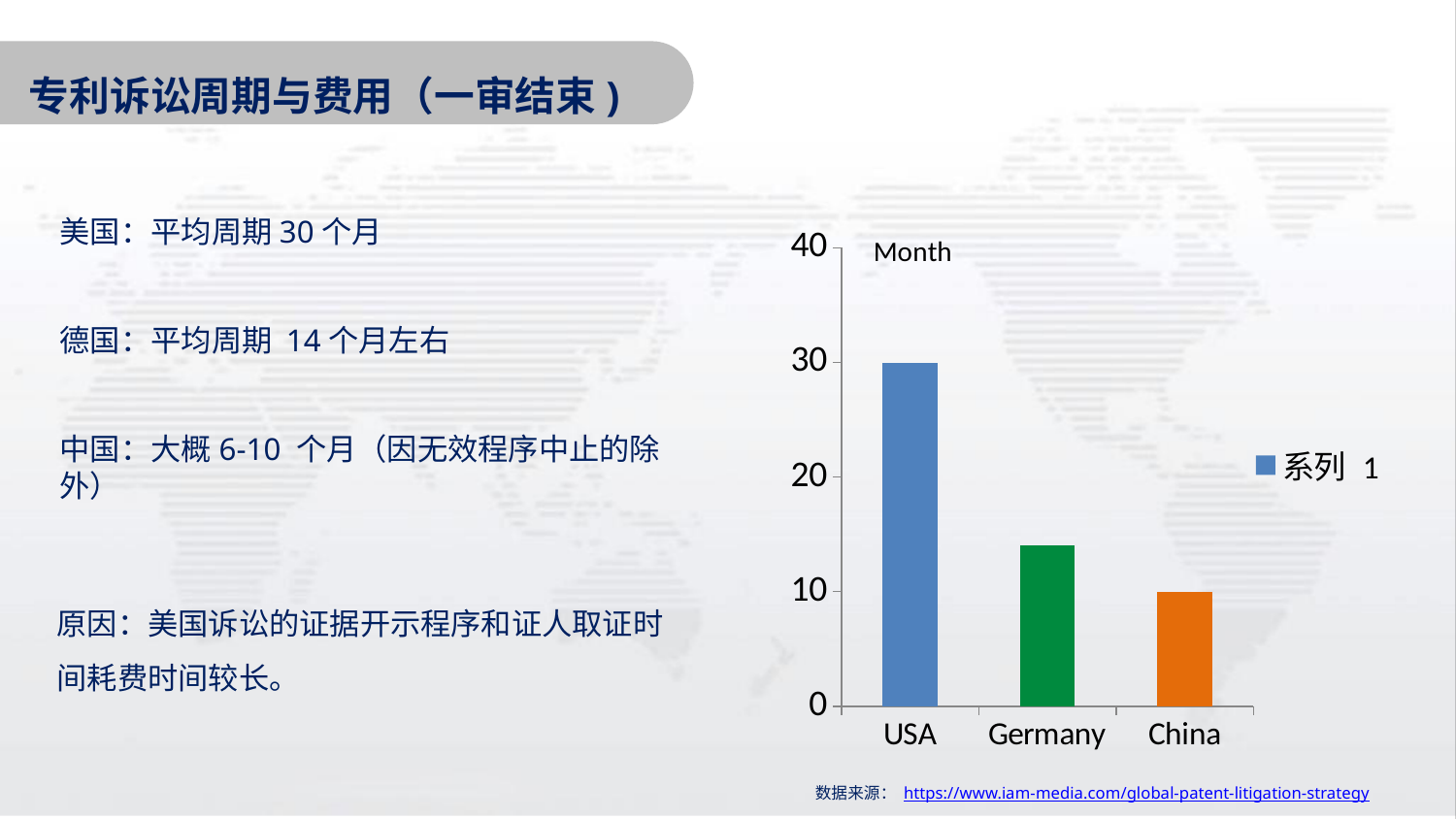
Which country has the lowest bar in the chart? China Which is larger, the value for Germany or the value for China? Germany Is the value for Germany greater or less than 10? greater What is the difference between the values for USA and China? 20 Is the value for Germany greater or less than 20? less How many countries are shown on the x axis of the chart? 3 Which country has the highest bar in the chart? USA What type of chart is shown on the slide? bar chart What is the value for China in the chart? 10 What is the value for USA in the chart? 30 What is the name of the series shown in the chart legend? 系列 1 How many series does the chart legend list? 1